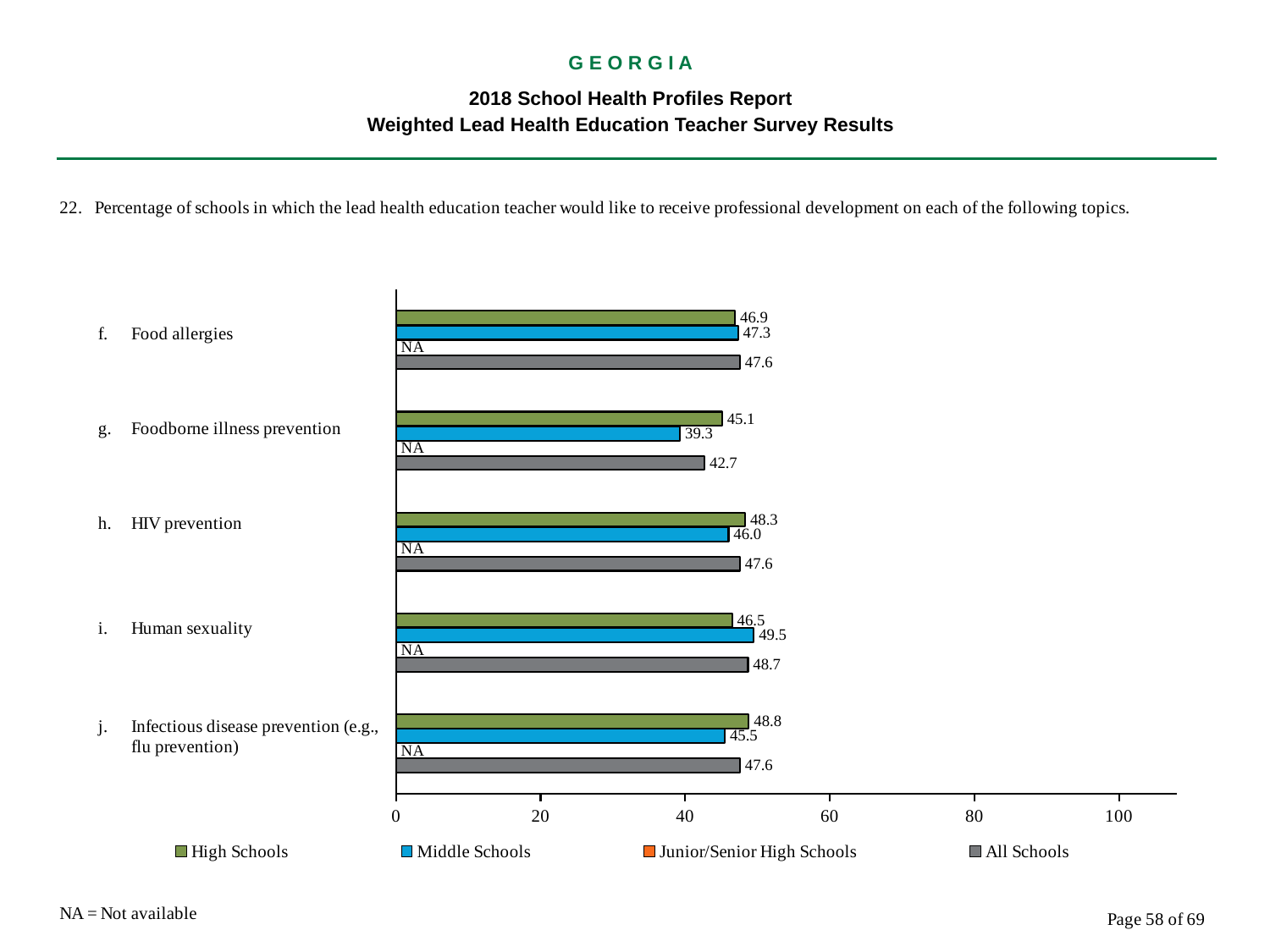
What is the All Schools value for Human sexuality? 48.7 Which topic has the lowest Middle Schools value? Foodborne illness prevention How many topics are shown on the chart? 5 What is the difference between the High Schools and Middle Schools values for Foodborne illness prevention? 5.8 What is the Middle Schools value for Infectious disease prevention (e.g., flu prevention)? 45.5 Which is larger for Human sexuality: the High Schools value or the Middle Schools value? Middle Schools How many series does the legend list? 4 Which topic has the highest High Schools value? Infectious disease prevention (e.g., flu prevention) What is the Middle Schools value for Foodborne illness prevention? 39.3 What kind of chart is shown on the slide? Bar chart Is the All Schools value for Foodborne illness prevention greater or less than 40? greater What is the High Schools value for Food allergies? 46.9